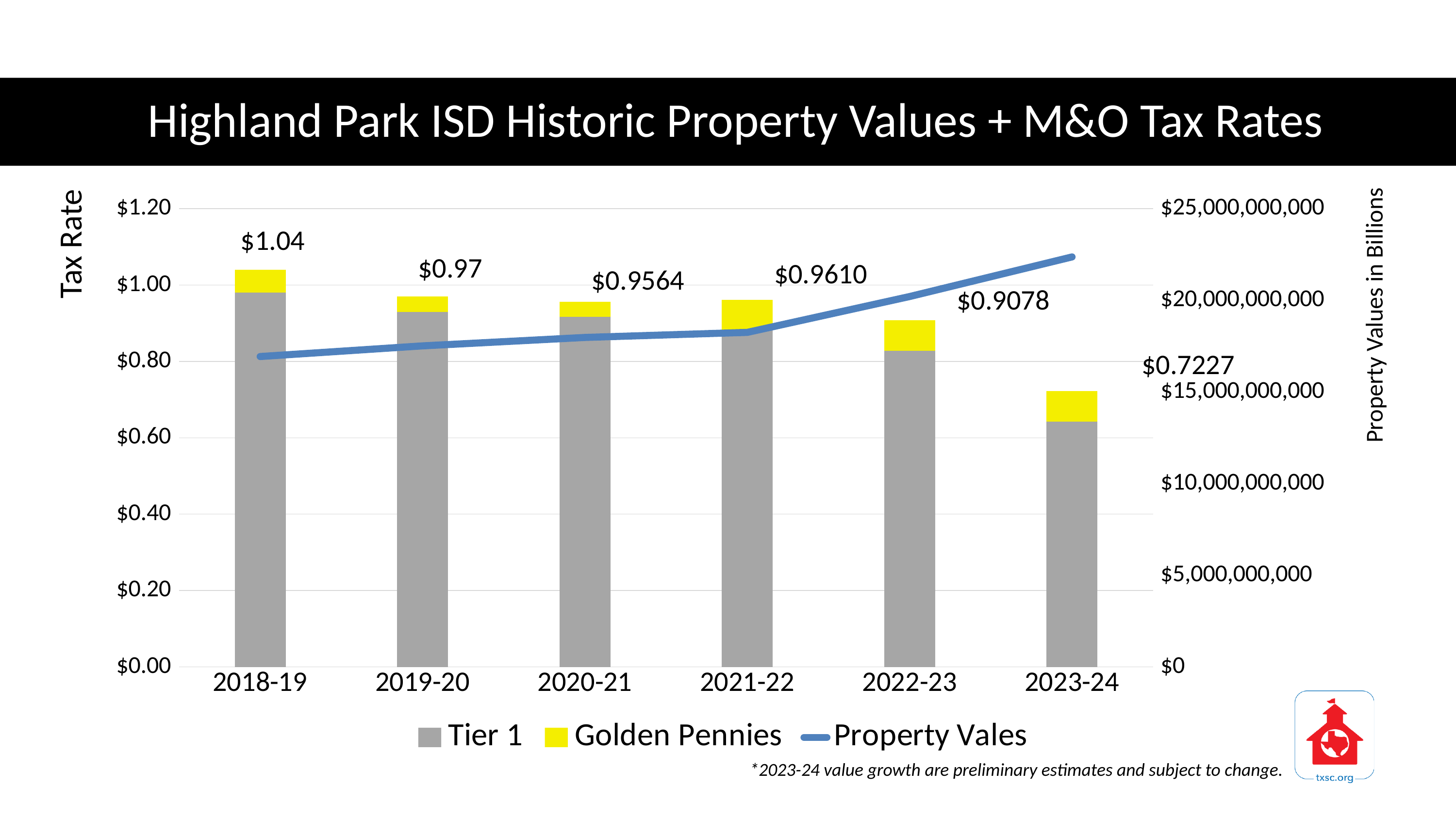
Which school year has the lowest total tax rate? 2023-24 What is the total M&O tax rate labelled for 2018-19? $1.04 Is the property value for 2023-24 greater or less than $20,000,000,000? greater What is the difference between the total tax rate in 2018-19 and in 2023-24? $0.3173 Which school year has the highest total tax rate? 2018-19 How many series does the legend list? 3 What is the total M&O tax rate labelled for 2021-22? $0.9610 How many school years are shown on the x axis? 6 Which has the larger total tax rate, 2019-20 or 2022-23? 2019-20 Is the property value for 2018-19 greater or less than $20,000,000,000? less Do the property values rise or fall from 2018-19 to 2023-24? rise What is the total M&O tax rate labelled for 2023-24? $0.7227